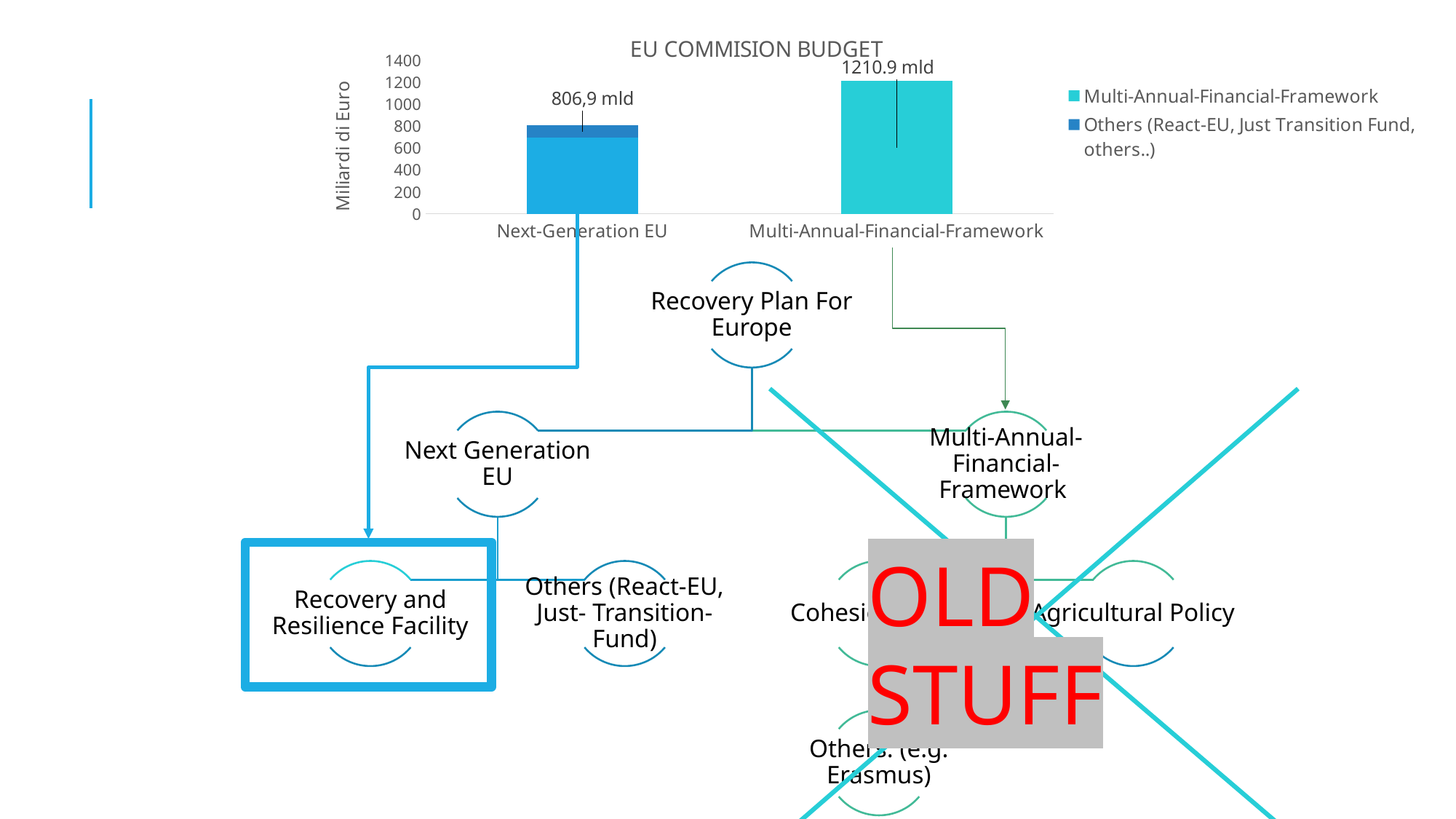
What is the label on the vertical axis of the chart? Miliardi di Euro Is the value for Multi-Annual-Financial-Framework greater or less than 1000? greater Which category has the highest bar in the EU COMMISION BUDGET chart? Multi-Annual-Financial-Framework What is the title of the chart? EU COMMISION BUDGET Is the value for Next-Generation EU greater or less than 1000? less What value is labelled on the Next-Generation EU bar? 806,9 mld What kind of chart is shown on the slide? bar chart Which category has the lowest bar in the EU COMMISION BUDGET chart? Next-Generation EU What value is labelled on the Multi-Annual-Financial-Framework bar? 1210.9 mld Which is larger, the Next-Generation EU bar or the Multi-Annual-Financial-Framework bar? Multi-Annual-Financial-Framework How many series does the chart legend list? 2 How many categories are shown on the x axis of the chart? 2